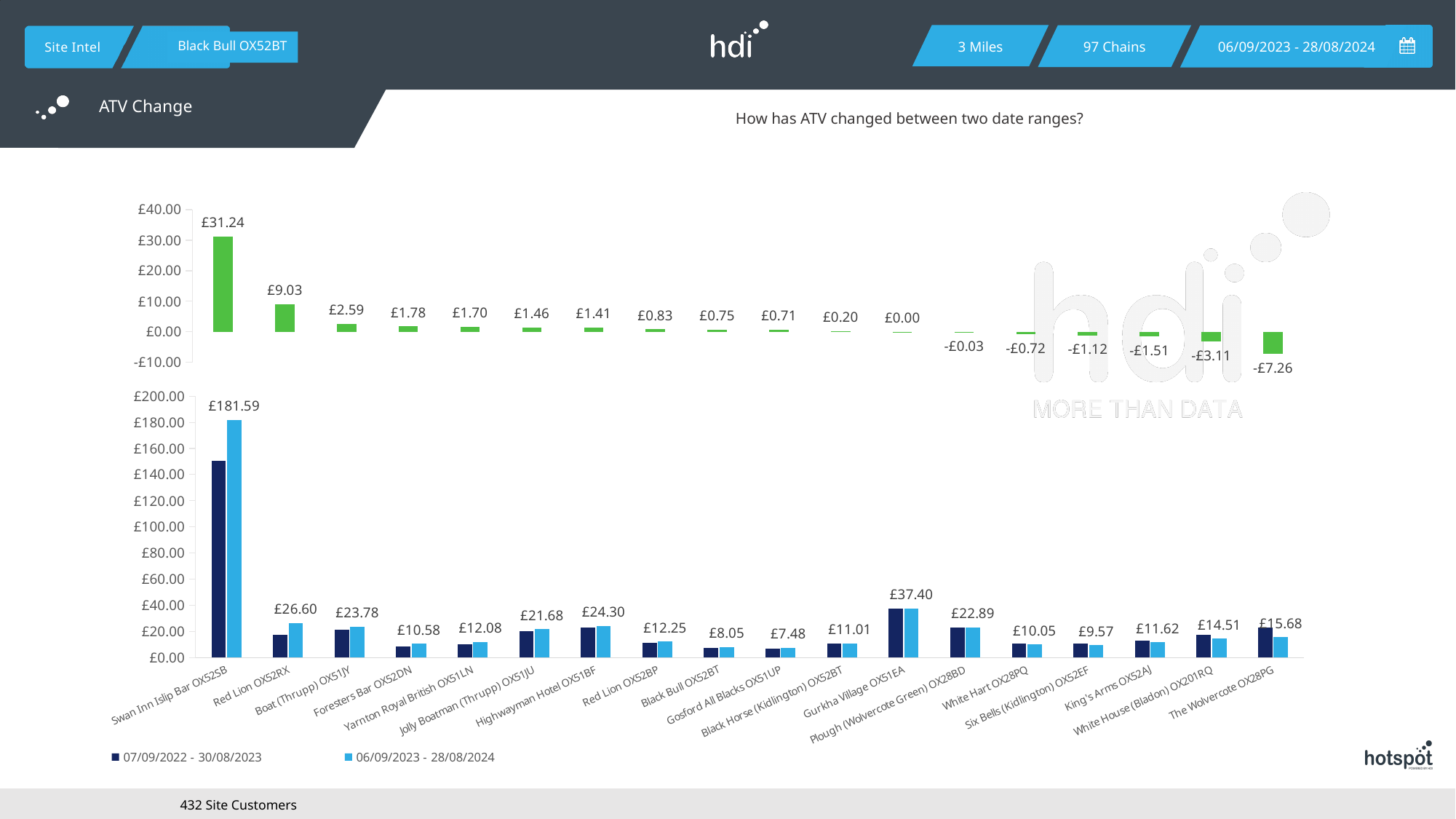
What kind of chart is the bottom chart? bar chart In the top chart (ATV change), what is the value for Swan Inn Islip Bar OX52SB? £31.24 In the bottom chart, what is the data label shown for Gurkha Village OX51EA? £37.40 In the top chart (ATV change), what is the difference between the values for Swan Inn Islip Bar OX52SB and Red Lion OX52RX? £22.21 In the bottom chart, is the 07/09/2022 - 30/08/2023 value for Swan Inn Islip Bar OX52SB greater or less than £140.00? greater In the top chart (ATV change), which site has the highest value? Swan Inn Islip Bar OX52SB In the bottom chart, which has the larger labelled value: Red Lion OX52RX or Highwayman Hotel OX51BF? Red Lion OX52RX How many sites are plotted along the x axis of the bottom chart? 18 In the top chart (ATV change), which site has the lowest value? The Wolvercote OX28PG How many series does the legend of the bottom chart list? 2 In the top chart (ATV change), what is the value for Black Bull OX52BT? £0.75 In the bottom chart, what is the data label shown for Swan Inn Islip Bar OX52SB? £181.59